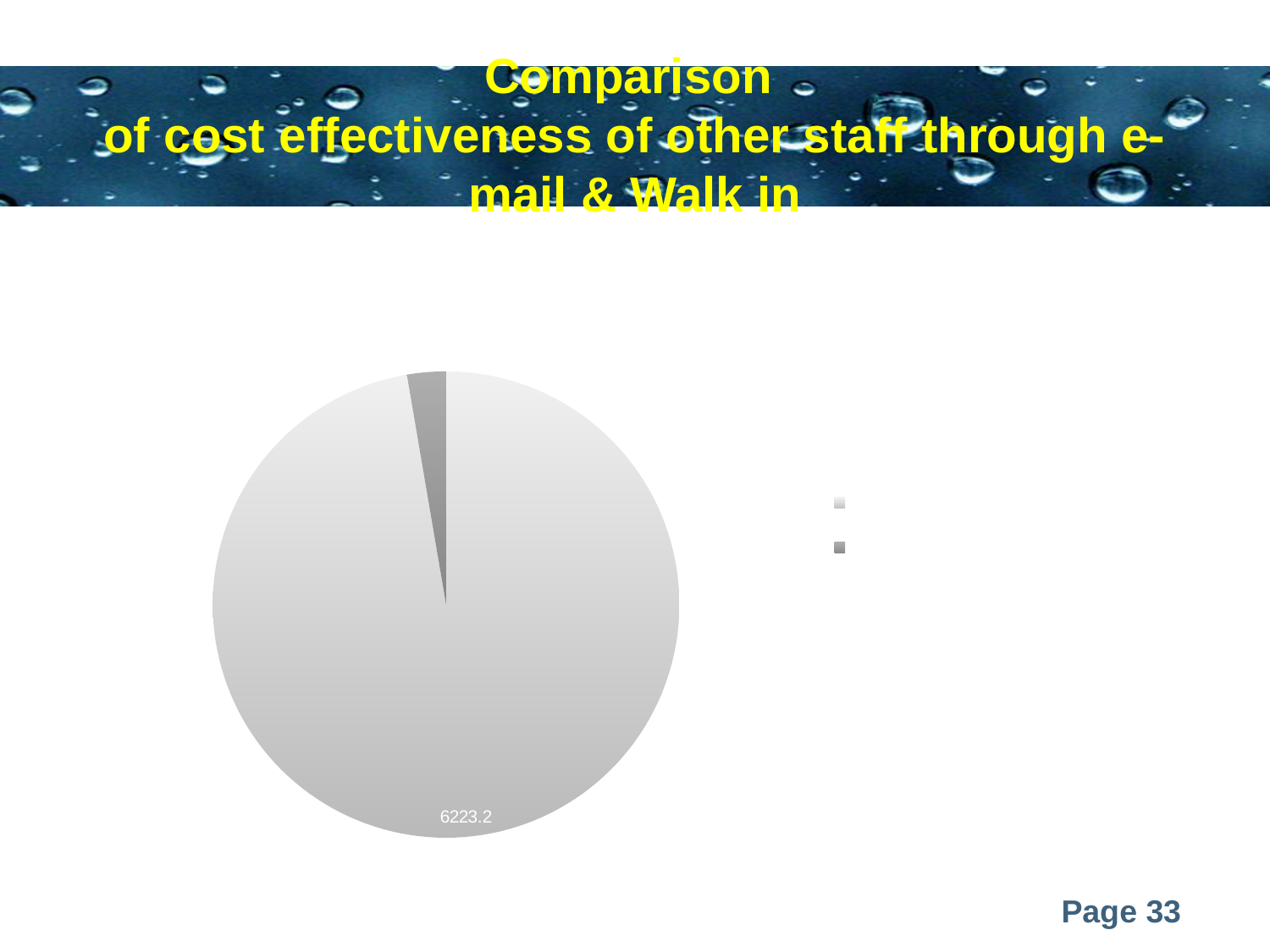
Which slice of the pie chart is larger, the light grey slice or the dark grey slice? the light grey slice What colour is the largest slice of the pie chart? light grey Is the value of the light grey slice of the pie chart greater or less than 6000? greater What value is printed as the data label on the large light grey slice of the pie chart? 6223.2 What is the title of the slide containing the pie chart? Comparison of cost effectiveness of other staff through e-mail & Walk in Which slice of the pie chart is the smallest? the dark grey slice How many entries does the legend of the pie chart list? 2 How many slices does the pie chart have? 2 What kind of chart is shown on the slide? pie chart